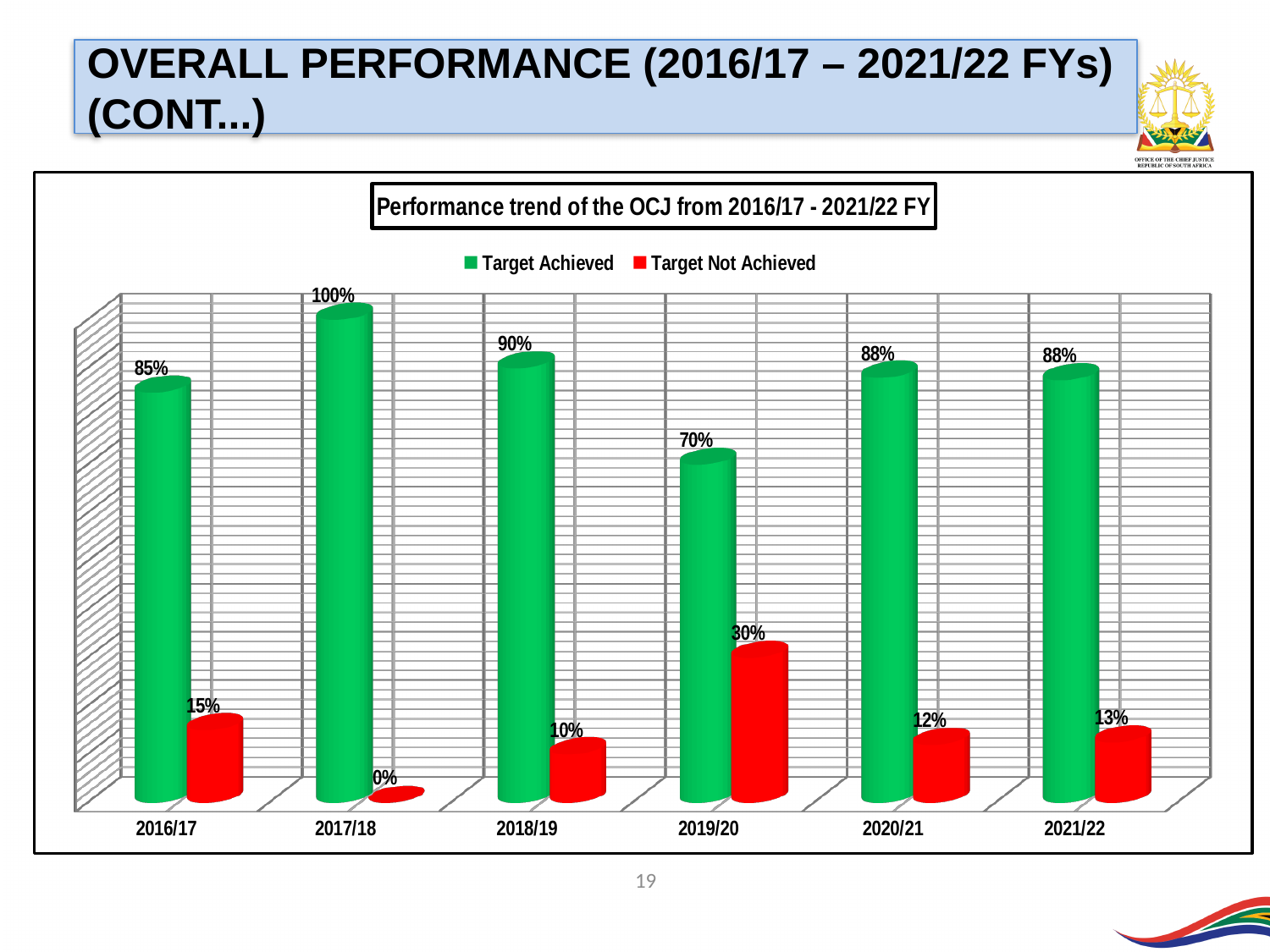
Which colour represents Target Not Achieved in the chart? Red What is the Target Not Achieved value for 2019/20? 30% What percentage of targets were achieved in 2017/18? 100% Which financial year has the lowest Target Achieved value? 2019/20 What is the title of the chart? Performance trend of the OCJ from 2016/17 - 2021/22 FY What kind of chart is shown on the slide? Bar chart Which is larger, the Target Not Achieved value for 2016/17 or for 2021/22? 2016/17 How many financial years are shown on the x axis? 6 Which financial year has the highest Target Not Achieved value? 2019/20 What is the Target Achieved value for 2016/17? 85% What is the difference between the Target Achieved values for 2018/19 and 2019/20? 20% How many series does the legend list? 2